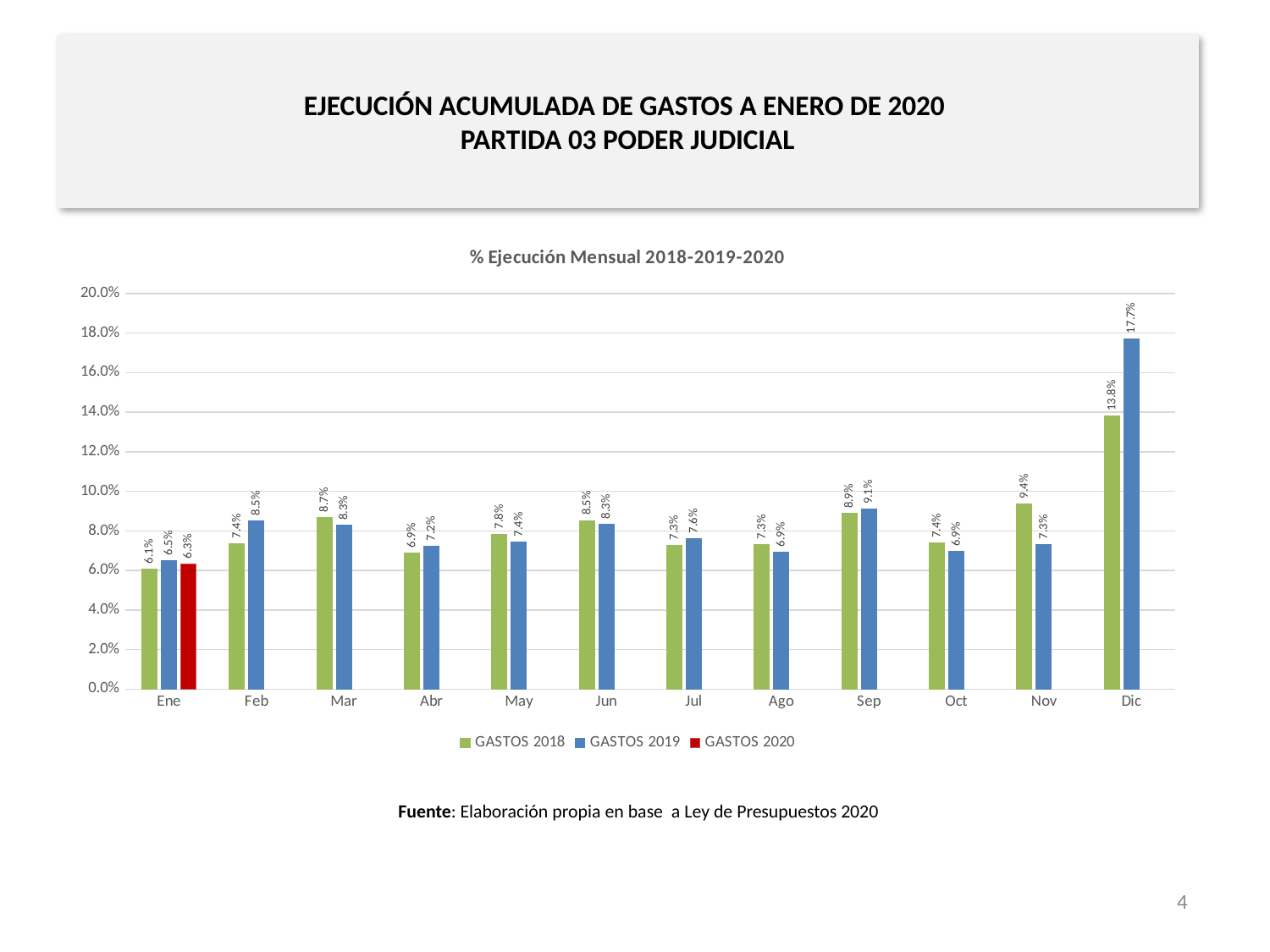
What is the value for GASTOS 2018 in Nov? 9.4% Which month has the lowest value for GASTOS 2019? Ene Which month has the highest value for GASTOS 2018? Dic What is the difference between GASTOS 2019 and GASTOS 2018 in Dic? 3.9% How many series does the legend list? 3 Which is larger in Nov, GASTOS 2018 or GASTOS 2019? GASTOS 2018 What kind of chart is shown? Bar chart How many months are shown on the x axis? 12 What is the value for GASTOS 2020 in Ene? 6.3% Is the value for GASTOS 2019 in Dic greater or less than 16.0%? greater What is the title of the chart? % Ejecución Mensual 2018-2019-2020 What is the value for GASTOS 2019 in Dic? 17.7%